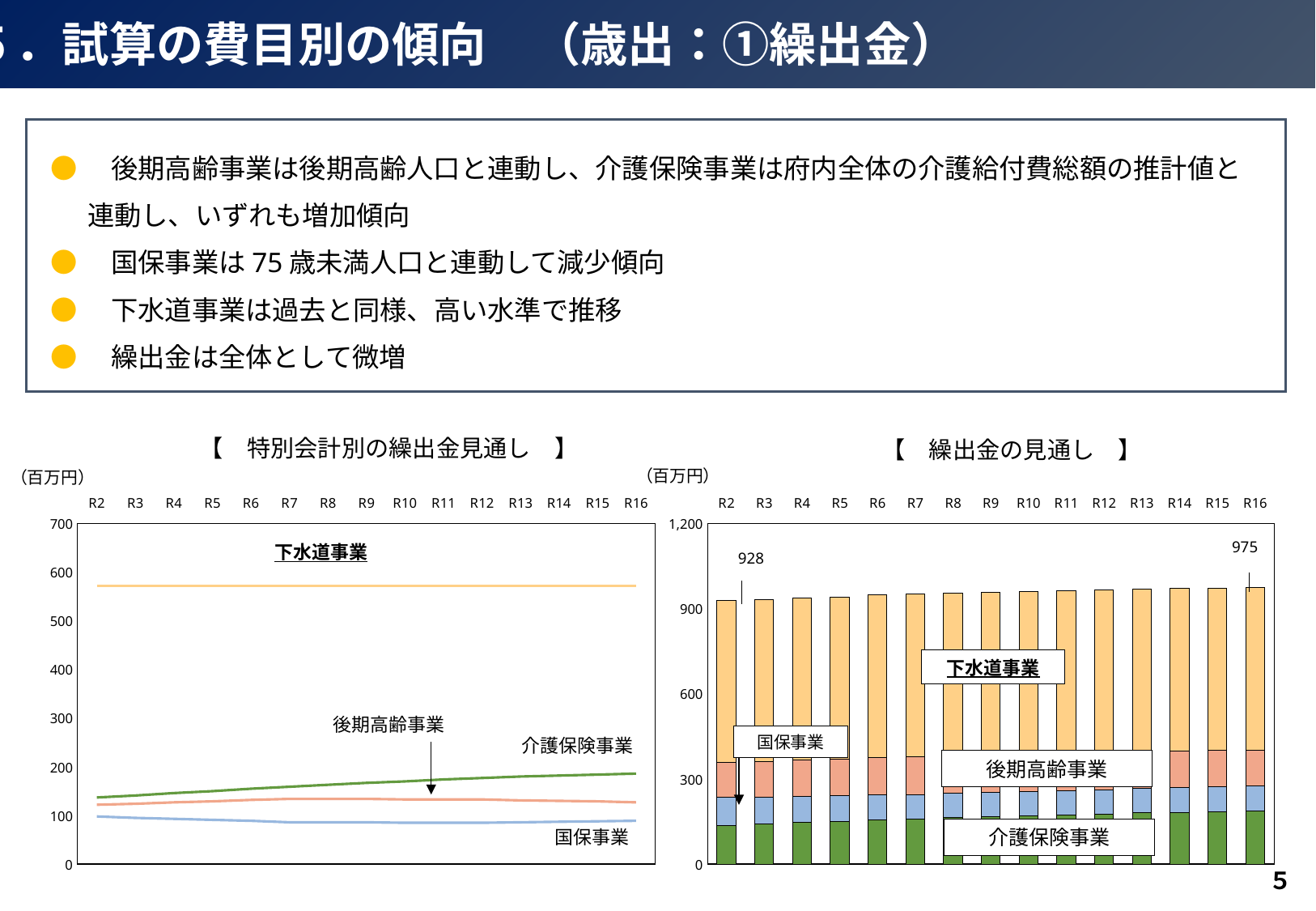
What kind of chart is the chart titled 繰出金の見通し? stacked bar chart In the chart titled 特別会計別の繰出金見通し, which series has the lowest values? 国保事業 In the chart titled 繰出金の見通し, which is larger, the total for R2 or the total for R16? R16 In the chart titled 特別会計別の繰出金見通し, is the value for 下水道事業 in R2 greater or less than 500? greater What kind of chart is the chart titled 特別会計別の繰出金見通し? line chart How many years are shown on the x axis of the chart titled 特別会計別の繰出金見通し? 15 In the chart titled 特別会計別の繰出金見通し, which series has the highest values? 下水道事業 In the chart titled 繰出金の見通し, what is the total value for R16? 975 In the chart titled 特別会計別の繰出金見通し, does the 介護保険事業 line rise or fall from R2 to R16? rise In the chart titled 繰出金の見通し, is the total for R2 greater or less than 900? greater In the chart titled 繰出金の見通し, what is the total value for R2? 928 In the chart titled 繰出金の見通し, what is the difference between the R16 total and the R2 total? 47